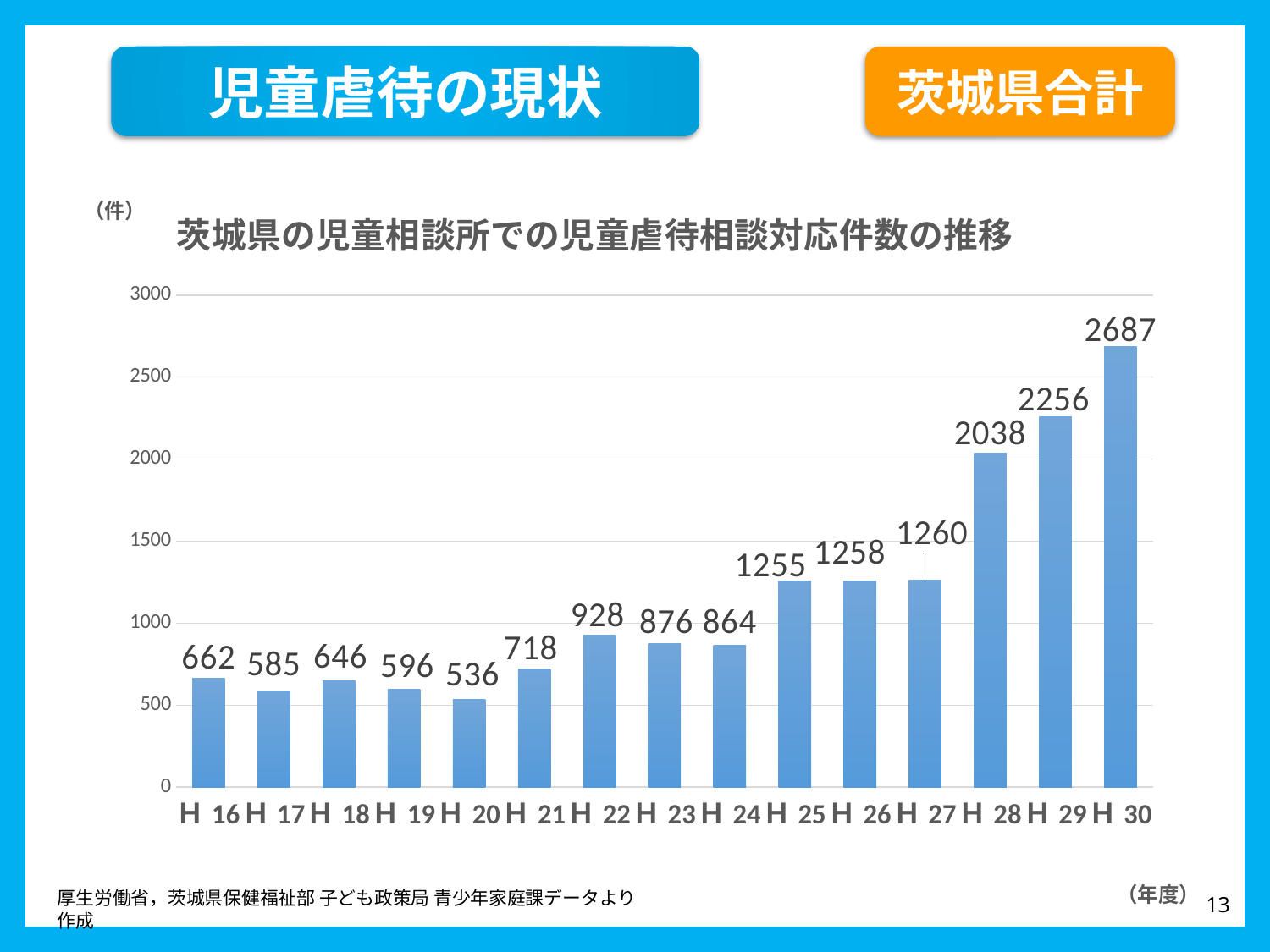
Is the value for H 28 greater or less than 2000? greater What is the title of the chart? 茨城県の児童相談所での児童虐待相談対応件数の推移 What is the difference between the values for H 30 and H 29? 431 What is the difference between the values for H 28 and H 27? 778 Which year has the highest value? H 30 What is the value for H 20? 536 What is the value for H 22? 928 Which year has the lowest value? H 20 What kind of chart is shown on the slide? bar chart What is the value for H 30? 2687 Which is larger, the value for H 16 or the value for H 18? H 16 How many years are shown on the x axis? 15